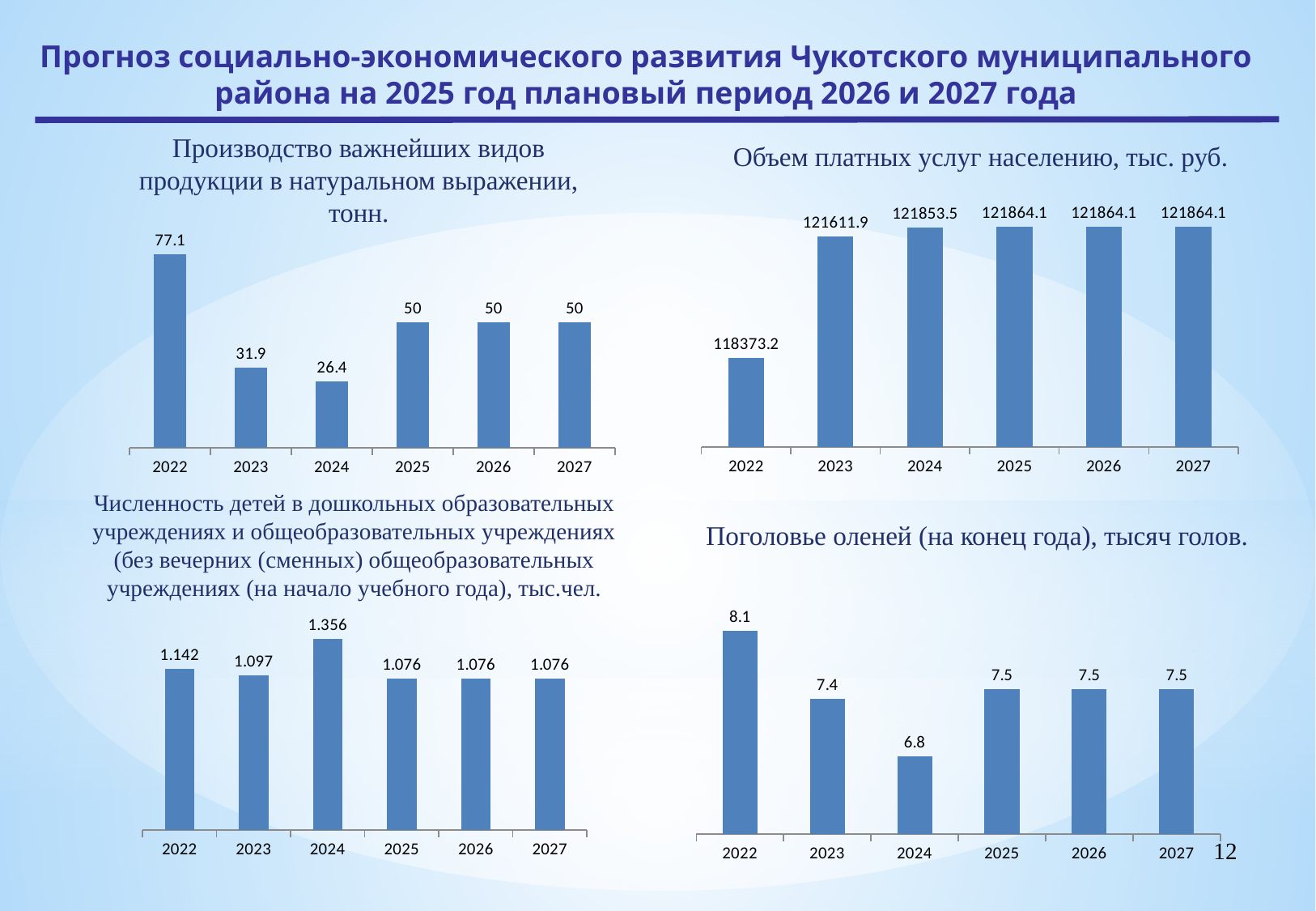
In the top-left chart (Производство важнейших видов продукции в натуральном выражении, тонн.), what is the value for 2022? 77.1 In the bottom-left chart (Численность детей в дошкольных образовательных учреждениях...), what is the value for 2024? 1.356 In the top-left chart (Производство важнейших видов продукции), which year has the lowest value? 2024 In the top-left chart (Производство важнейших видов продукции), what is the difference between the values for 2022 and 2023? 45.2 In the bottom-left chart (Численность детей...), which year has the highest value? 2024 What type of chart is the bottom-right chart (Поголовье оленей)? Bar chart In the top-right chart (Объем платных услуг населению), how many years are shown on the x axis? 6 In the bottom-right chart (Поголовье оленей (на конец года), тысяч голов.), what is the value for 2024? 6.8 In the top-right chart (Объем платных услуг населению), which year has the lowest value? 2022 In the bottom-right chart (Поголовье оленей), what is the difference between the values for 2022 and 2024? 1.3 In the top-right chart (Объем платных услуг населению, тыс. руб.), what is the value for 2023? 121611.9 In the bottom-left chart (Численность детей...), which is larger, the value for 2022 or the value for 2023? 2022